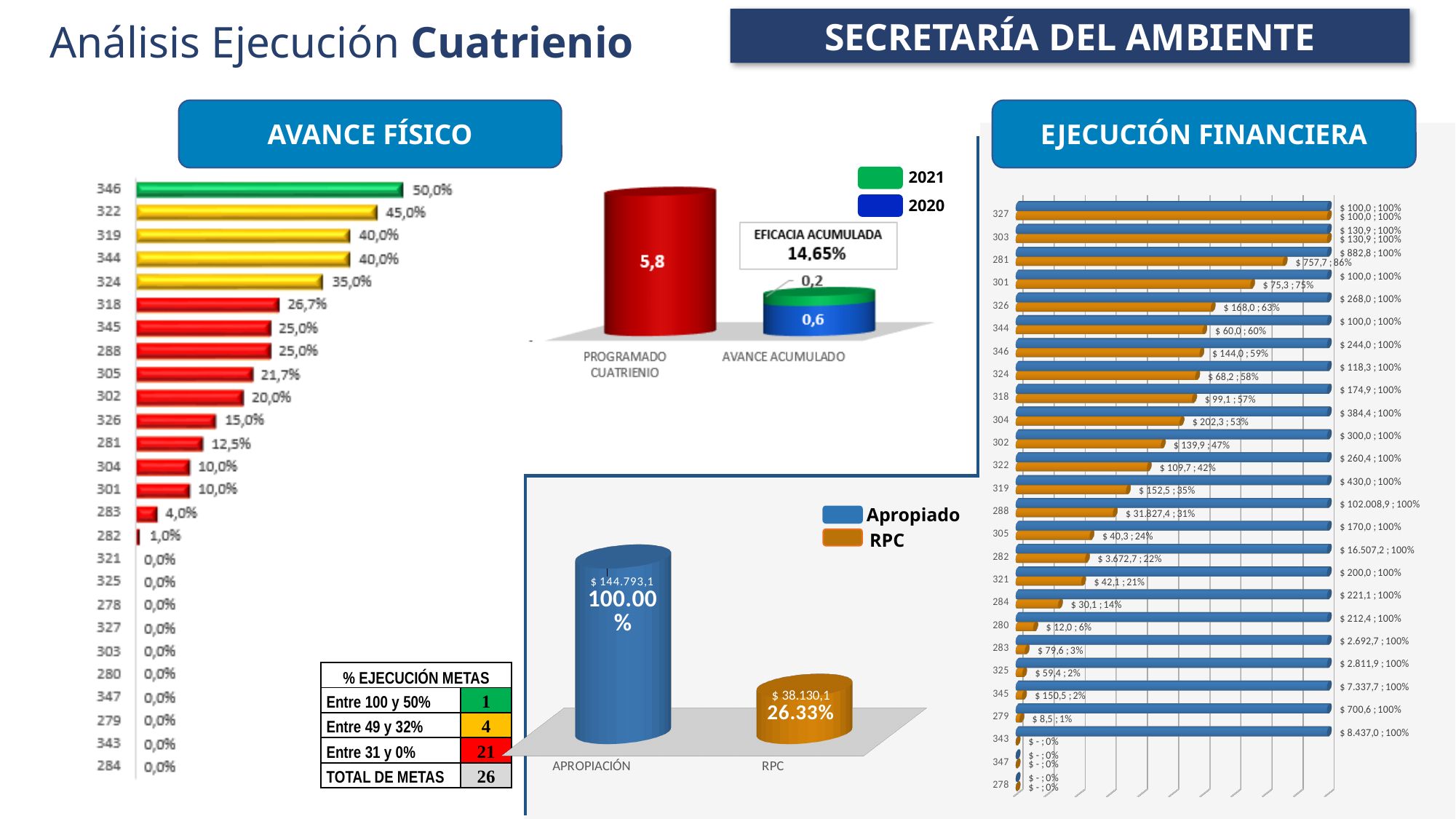
In the Avance Físico chart, which is larger, the value for 305 or the value for 326? 305 In the Avance Físico chart, what is the difference between the values for 322 and 318? 18,3% In the Avance Físico chart, what is the value for category 346? 50,0% In the Ejecución Financiera chart, what is the RPC value for category 281? $ 757,7 What type of chart is the Ejecución Financiera chart? bar chart In the Programado Cuatrienio vs Avance Acumulado chart, what is the total of the stacked Avance Acumulado bar? 0,8 How many categories are plotted in the Avance Físico chart? 26 In the Programado Cuatrienio vs Avance Acumulado chart, what is the 2021 value for Avance Acumulado? 0,2 In the Programado Cuatrienio vs Avance Acumulado chart, what is the value for Programado Cuatrienio? 5,8 How many series does the legend of the Ejecución Financiera chart list? 2 In the Avance Físico chart, which category has the highest value? 346 In the Apropiación vs RPC chart, what value is shown for RPC? $ 38.130,1